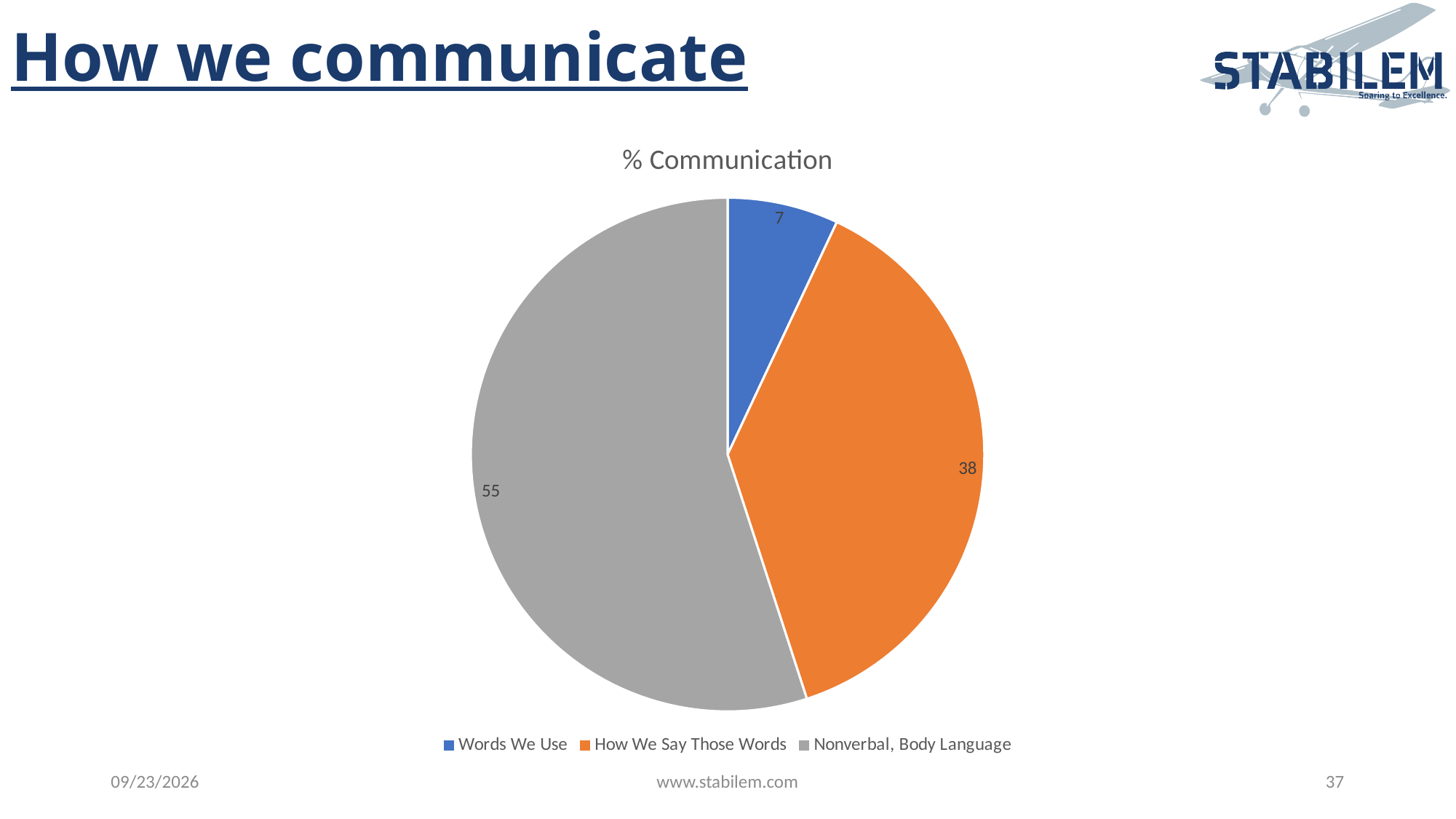
What is the value for Words We Use? 7 What colour is the slice for How We Say Those Words? Orange Which category has the smallest slice? Words We Use Which is larger, the value for How We Say Those Words or the value for Words We Use? How We Say Those Words What kind of chart is shown on the slide? Pie chart What is the difference between the values for Nonverbal, Body Language and How We Say Those Words? 17 What is the value for How We Say Those Words? 38 How many slices does the pie chart have? 3 What is the title of the chart? % Communication What is the value for Nonverbal, Body Language? 55 What is the difference between the values for How We Say Those Words and Words We Use? 31 Which category has the largest slice? Nonverbal, Body Language